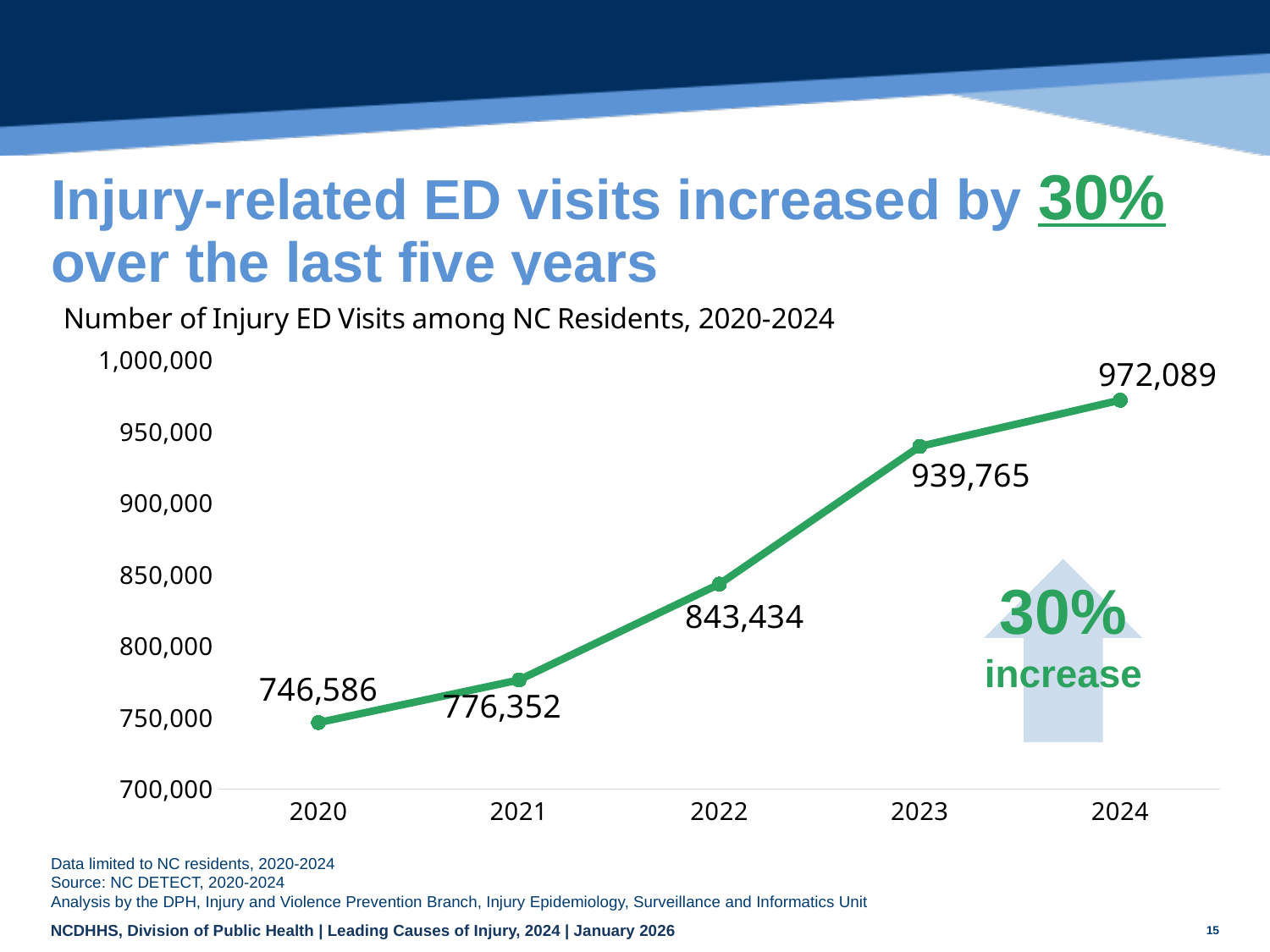
Is the number of injury ED visits in 2022 greater or less than 850,000? less What is the difference in injury ED visits between 2024 and 2020? 225,503 What is the number of injury ED visits among NC residents in 2022? 843,434 What is the difference in injury ED visits between 2023 and 2022? 96,331 What kind of chart is shown on the slide? line chart What is the number of injury ED visits among NC residents in 2024? 972,089 What is the number of injury ED visits among NC residents in 2020? 746,586 Which year had more injury ED visits, 2021 or 2023? 2023 Which year has the highest number of injury ED visits? 2024 How many years are plotted on the chart? 5 Do injury ED visits rise or fall from 2020 to 2024? rise Which year has the lowest number of injury ED visits? 2020